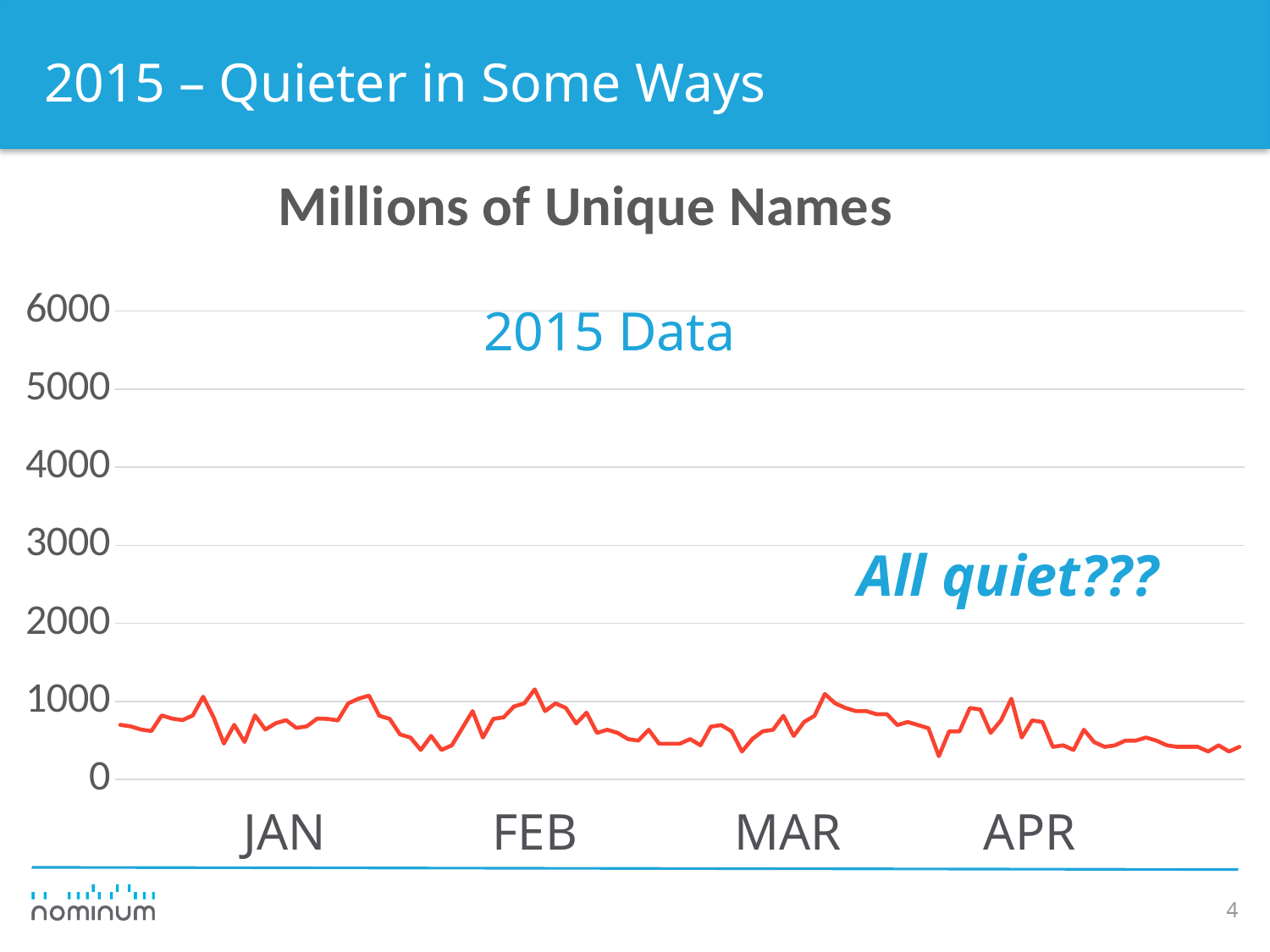
Is the value at the end of APR greater or less than 3000? less How many lines are plotted on the chart? 1 What is the lowest value shown on the y axis of the chart? 0 What kind of chart is shown on the slide? line chart Is the value at the start of JAN greater or less than 2000? less What is the highest value shown on the y axis of the chart? 6000 What is the title of the chart? Millions of Unique Names Which months are labelled on the x axis of the chart? JAN, FEB, MAR, APR Does the plotted line ever rise above 2000 on the chart? No How many month labels appear on the x axis of the chart? 4